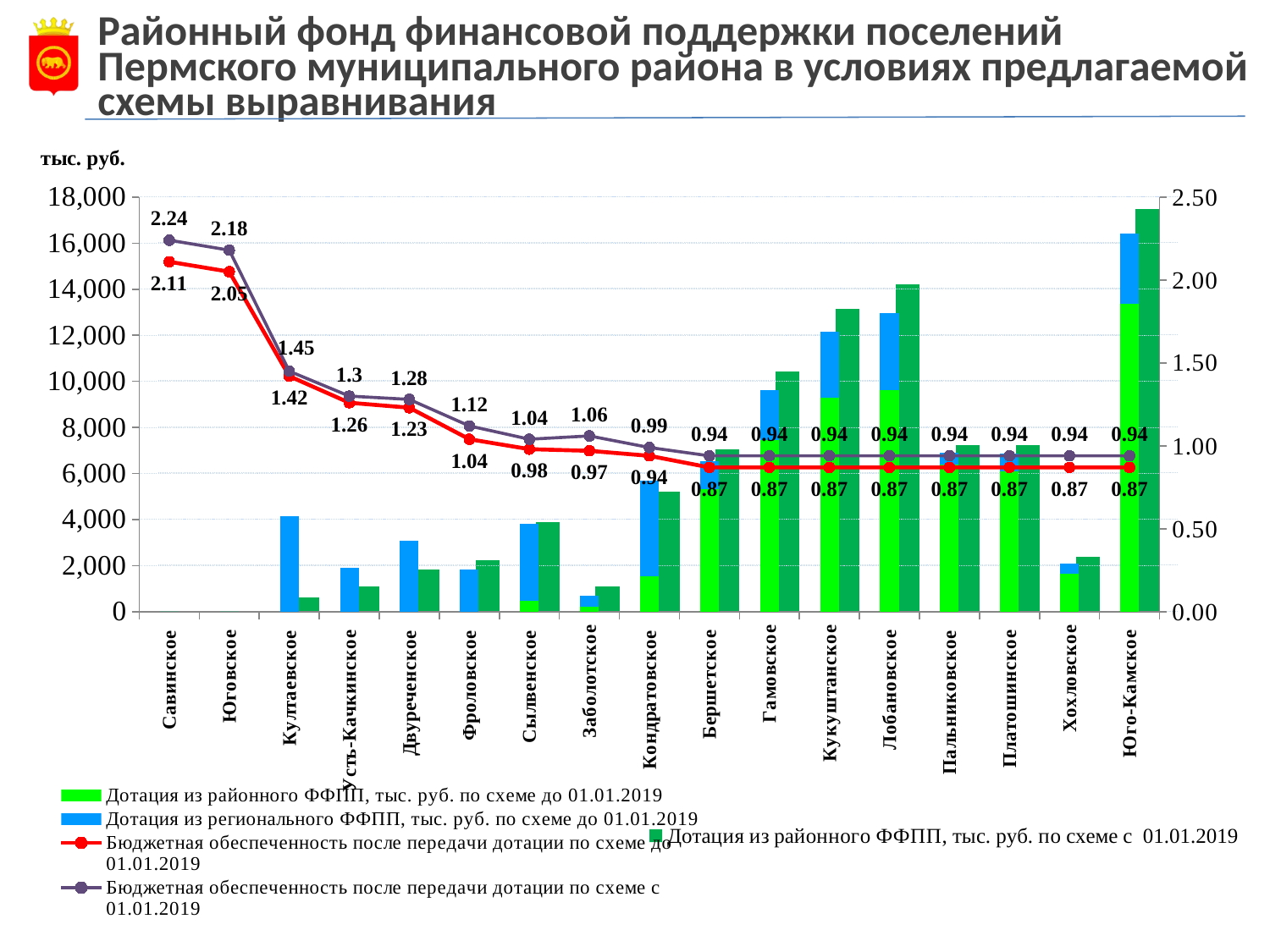
What is the value of the purple line (Бюджетная обеспеченность после передачи дотации по схеме с 01.01.2019) for Савинское? 2.24 How many categories (settlements) are shown on the x axis? 17 How many series does the legend list? 5 Which category has the highest value on the purple line? Савинское What kind of chart is shown on the slide? a combined bar and line chart What is the difference between the purple line value and the red line value for Савинское? 0.13 What is the value of the purple line for Култаевское? 1.45 What is the value of the red line for Сылвенское? 0.98 Do the values of the purple line rise or fall moving from left to right along the x axis? fall Is the dark green bar (Дотация из районного ФФПП по схеме с 01.01.2019) for Юго-Камское greater or less than 16,000? greater Which has the taller dark green bar (Дотация из районного ФФПП по схеме с 01.01.2019): Гамовское or Кукуштанское? Кукуштанское What is the value of the red line (Бюджетная обеспеченность после передачи дотации по схеме до 01.01.2019) for Юговское? 2.05